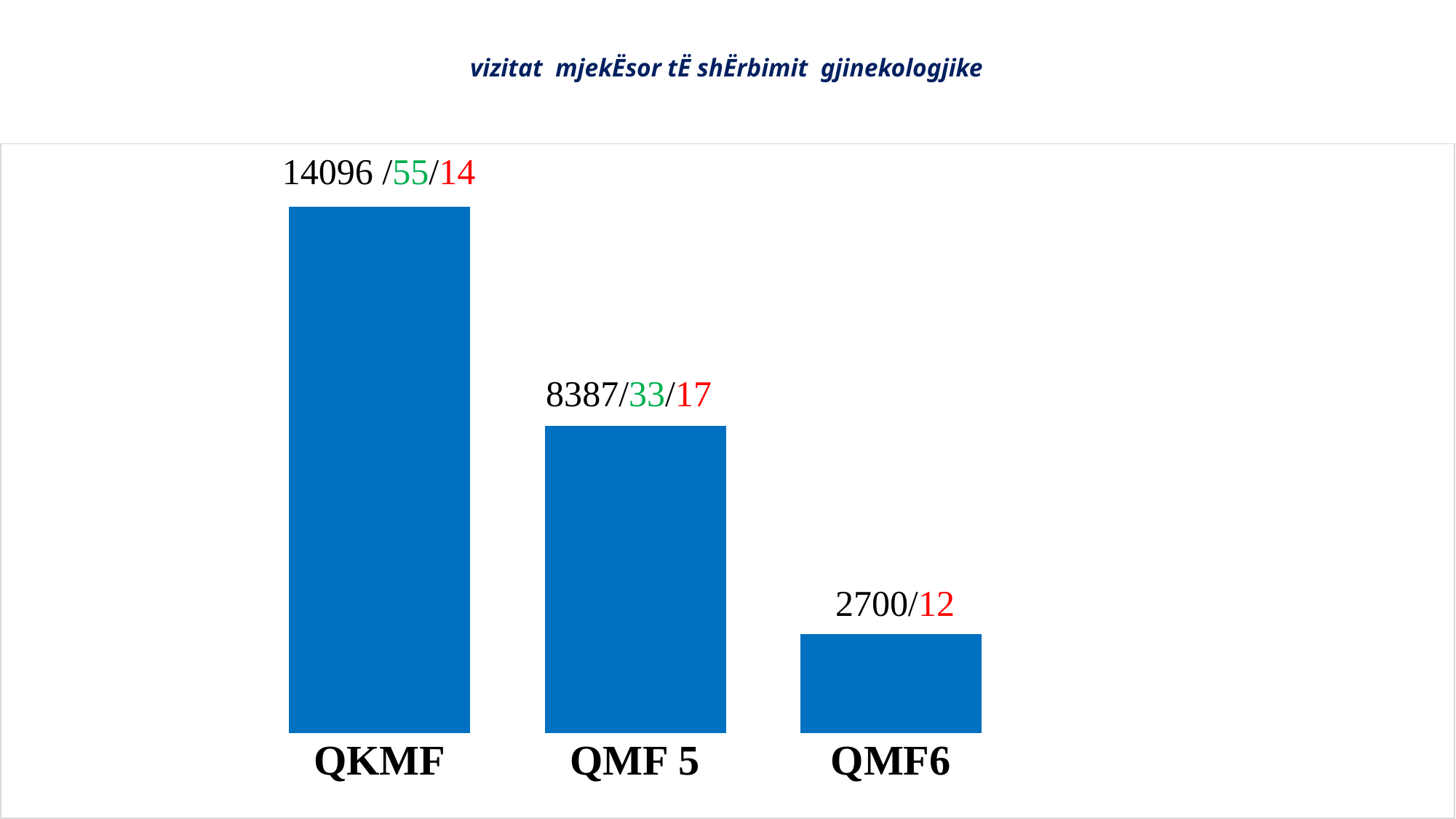
How many bars are shown in the chart? 3 What is the full data label printed above the QMF6 bar? 2700/12 What is the full data label printed above the QKMF bar? 14096 /55/14 Do the bar heights rise or fall from left to right across the categories? Fall Which bar is taller, QMF 5 or QMF6? QMF 5 Which category has the tallest bar? QKMF What is the difference between the first number in the QMF 5 label (8387) and the first number in the QMF6 label (2700)? 5687 What is the first number in the data label for QMF 5? 8387 Which category has the shortest bar? QMF6 What is the difference between the first number in the QKMF label (14096) and the first number in the QMF 5 label (8387)? 5709 What is the full data label printed above the QMF 5 bar? 8387/33/17 What kind of chart is shown on the slide? Bar chart